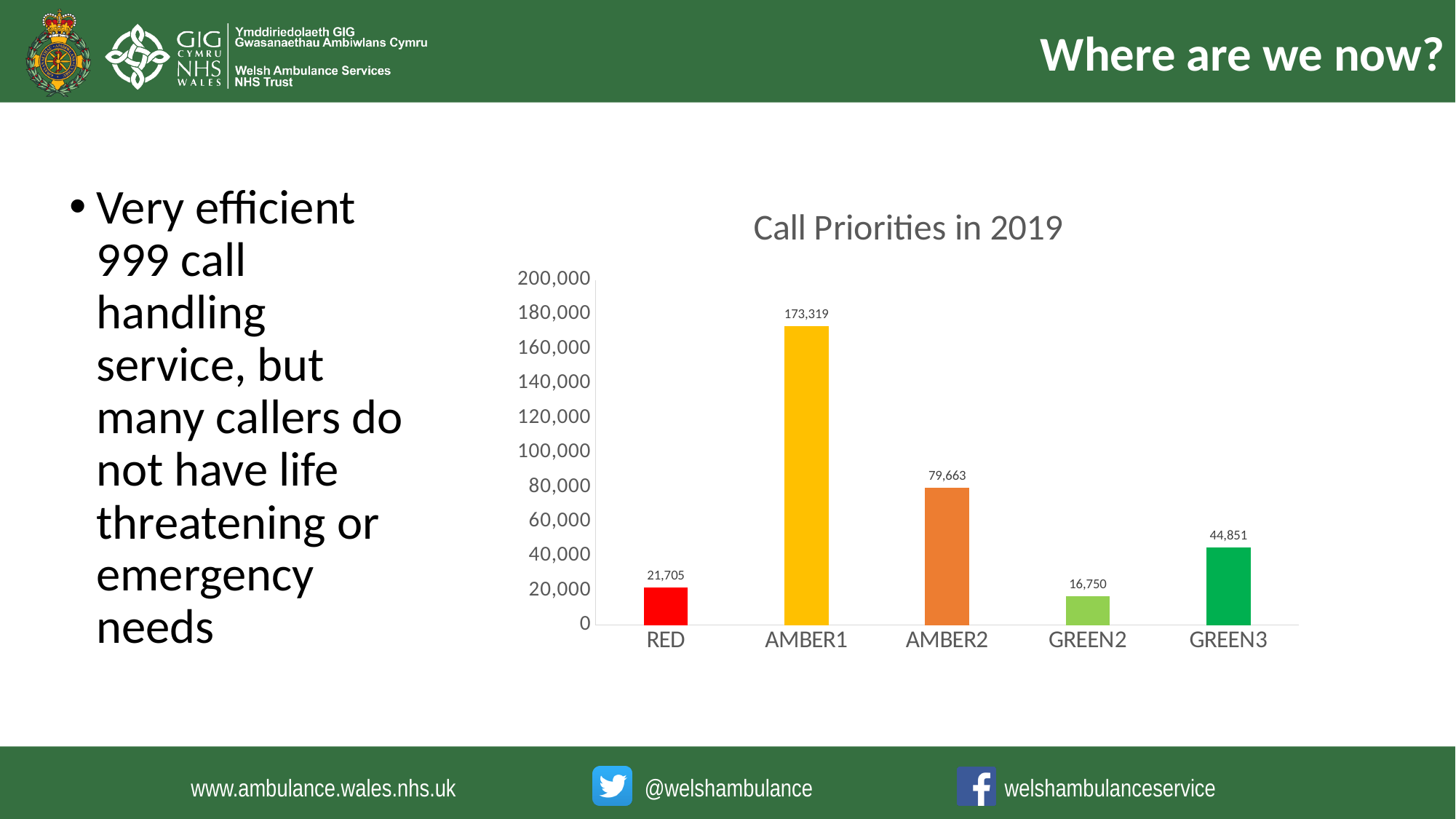
What is the value for AMBER1 in the Call Priorities in 2019 chart? 173,319 What is the title of the chart on the slide? Call Priorities in 2019 Which is larger in the Call Priorities in 2019 chart, GREEN3 or AMBER2? AMBER2 What is the difference between the AMBER1 and AMBER2 values in the Call Priorities in 2019 chart? 93,656 What is the value for GREEN2 in the Call Priorities in 2019 chart? 16,750 What kind of chart is the Call Priorities in 2019 chart? bar chart Is the value for AMBER2 in the Call Priorities in 2019 chart greater or less than 100,000? less Which category has the highest value in the Call Priorities in 2019 chart? AMBER1 How many categories are shown in the Call Priorities in 2019 chart? 5 Which category has the lowest value in the Call Priorities in 2019 chart? GREEN2 What is the value for RED in the Call Priorities in 2019 chart? 21,705 What is the difference between the GREEN3 and RED values in the Call Priorities in 2019 chart? 23,146